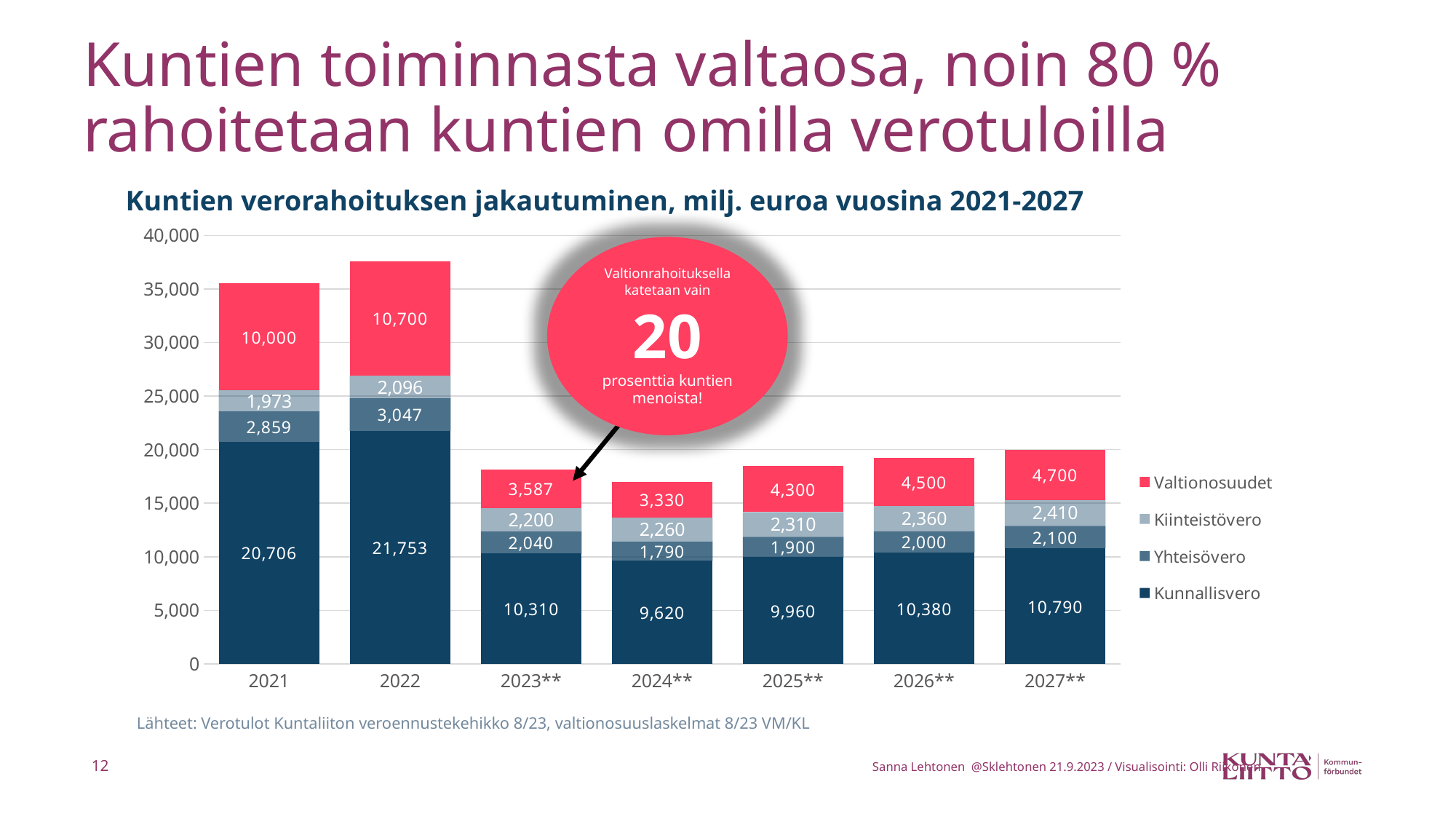
What is the difference between the Valtionosuudet values for 2022 and 2021? 700 Which year has the lowest Yhteisövero value? 2024** What is the Kiinteistövero value for 2027**? 2,410 Which is larger, the Kiinteistövero value for 2025** or the Yhteisövero value for 2025**? Kiinteistövero (2,310) What is the Kunnallisvero value for 2021? 20,706 Does the Valtionosuudet value rise or fall from 2023** to 2027**? Rises What is the Valtionosuudet value for 2024**? 3,330 Which year has the highest Kunnallisvero value? 2022 How many series does the legend list? 4 What is the total of the stacked bar for 2027**? 20,000 What kind of chart is shown on the slide? Stacked bar chart How many years are shown on the x axis? 7